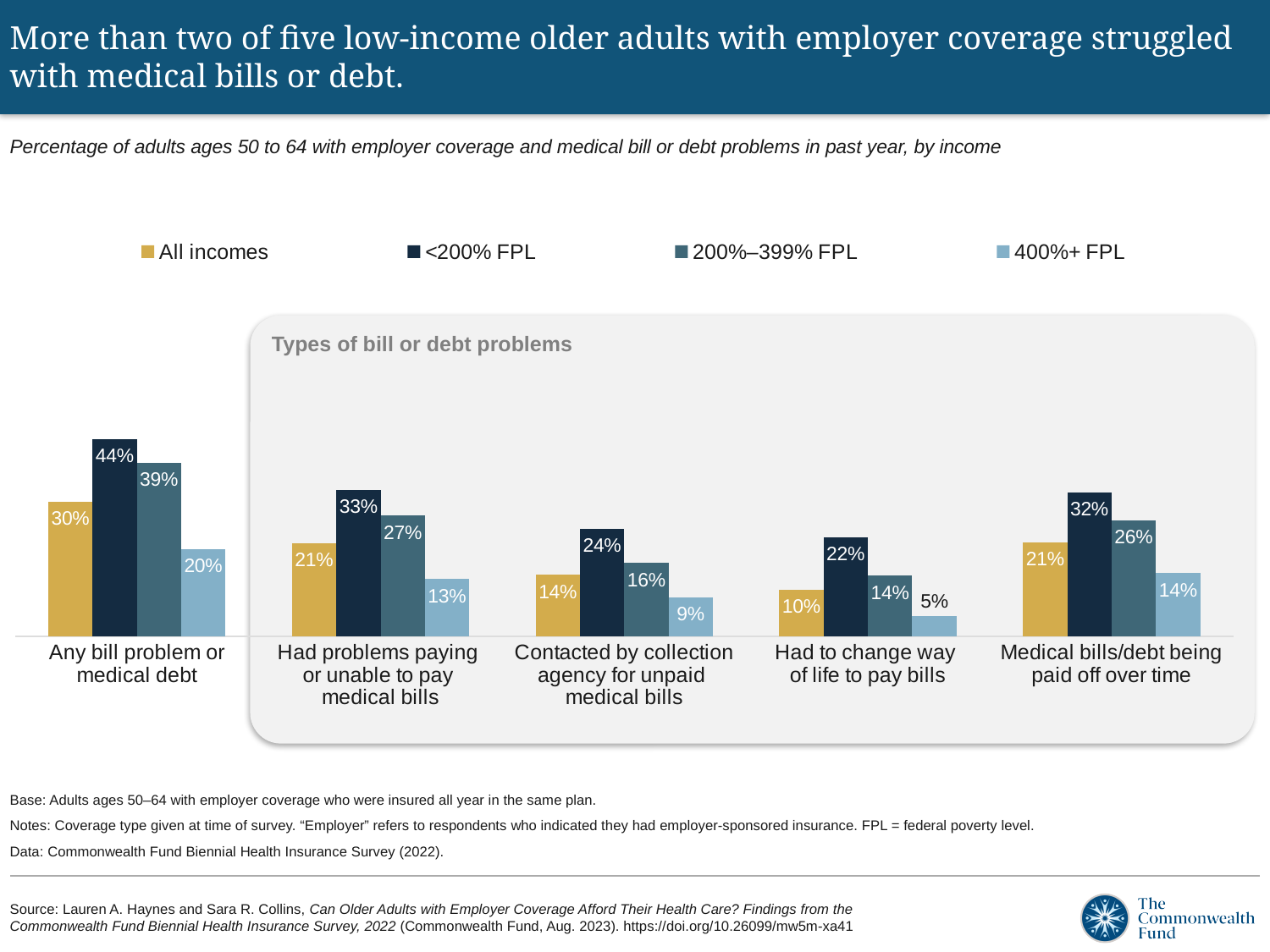
What is the value for the 200%–399% FPL group for 'Medical bills/debt being paid off over time'? 26% Which income group has the lowest value for 'Any bill problem or medical debt'? 400%+ FPL How many series does the legend list? 4 Which income group has the highest value for 'Had to change way of life to pay bills'? <200% FPL Which is larger: the 200%–399% FPL value for 'Had problems paying or unable to pay medical bills' or the 200%–399% FPL value for 'Medical bills/debt being paid off over time'? Had problems paying or unable to pay medical bills (27%) What kind of chart is shown on the slide? Bar chart What is the difference between the <200% FPL and 400%+ FPL values for 'Any bill problem or medical debt'? 24 percentage points What percentage of adults with incomes below 200% FPL had any bill problem or medical debt? 44% What is the label of the shaded box grouping the four right-hand categories? Types of bill or debt problems What is the value for the 400%+ FPL group for 'Had problems paying or unable to pay medical bills'? 13% What percentage of all incomes were contacted by a collection agency for unpaid medical bills? 14% How many categories of bill or debt problems are shown on the x axis? 5